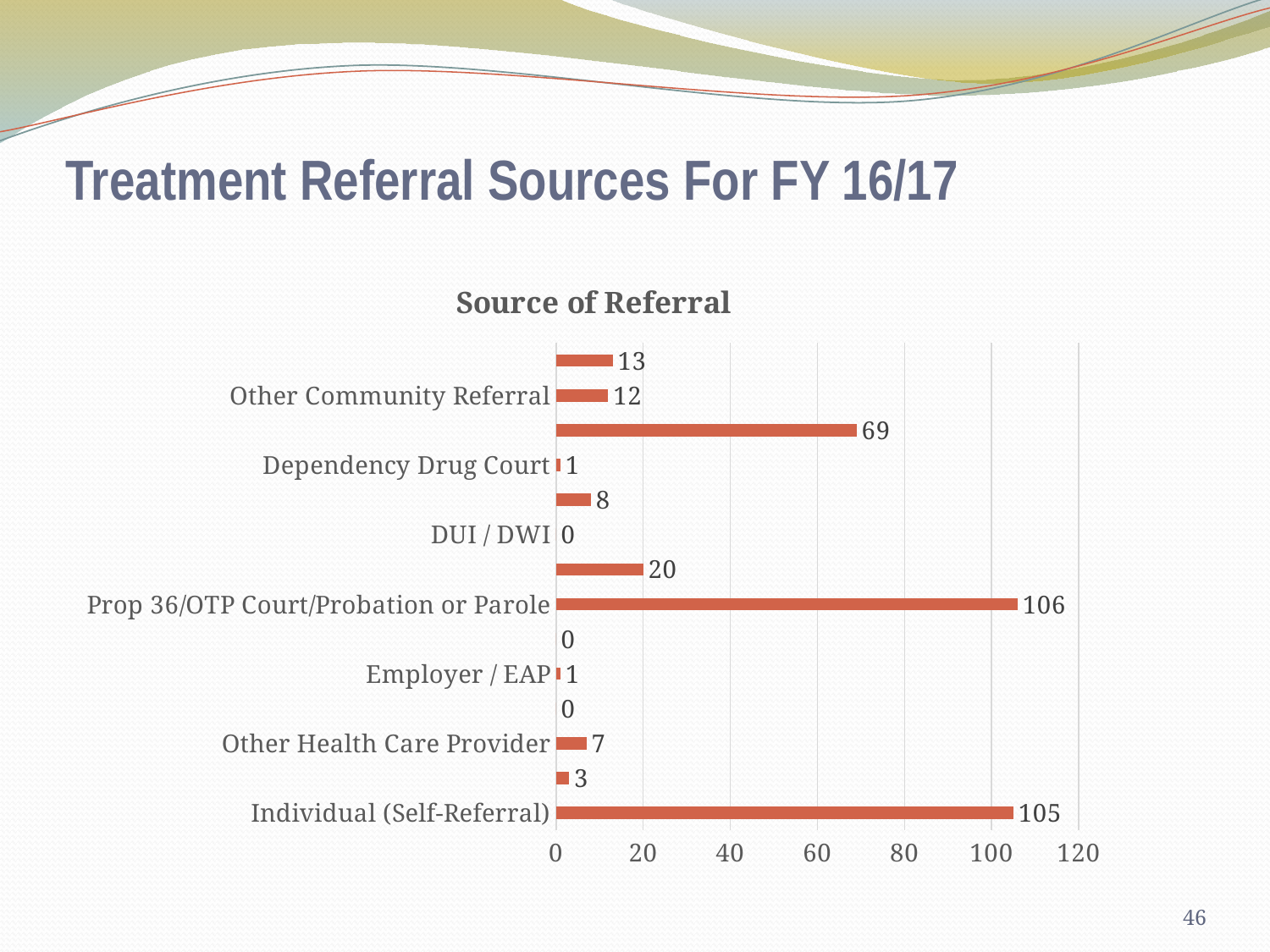
What is the value for Prop 36/OTP Court/Probation or Parole? 106 What is the value for Dependency Drug Court? 1 What kind of chart is shown? Bar chart What is the difference between Individual (Self-Referral) and Other Health Care Provider? 98 Which category has the highest value? Prop 36/OTP Court/Probation or Parole Which is larger, Prop 36/OTP Court/Probation or Parole or Individual (Self-Referral)? Prop 36/OTP Court/Probation or Parole What is the difference between Prop 36/OTP Court/Probation or Parole and Other Community Referral? 94 What is the title of the chart? Source of Referral What is the value for DUI / DWI? 0 What is the value for Other Health Care Provider? 7 What is the value for Other Community Referral? 12 What is the value for Individual (Self-Referral)? 105